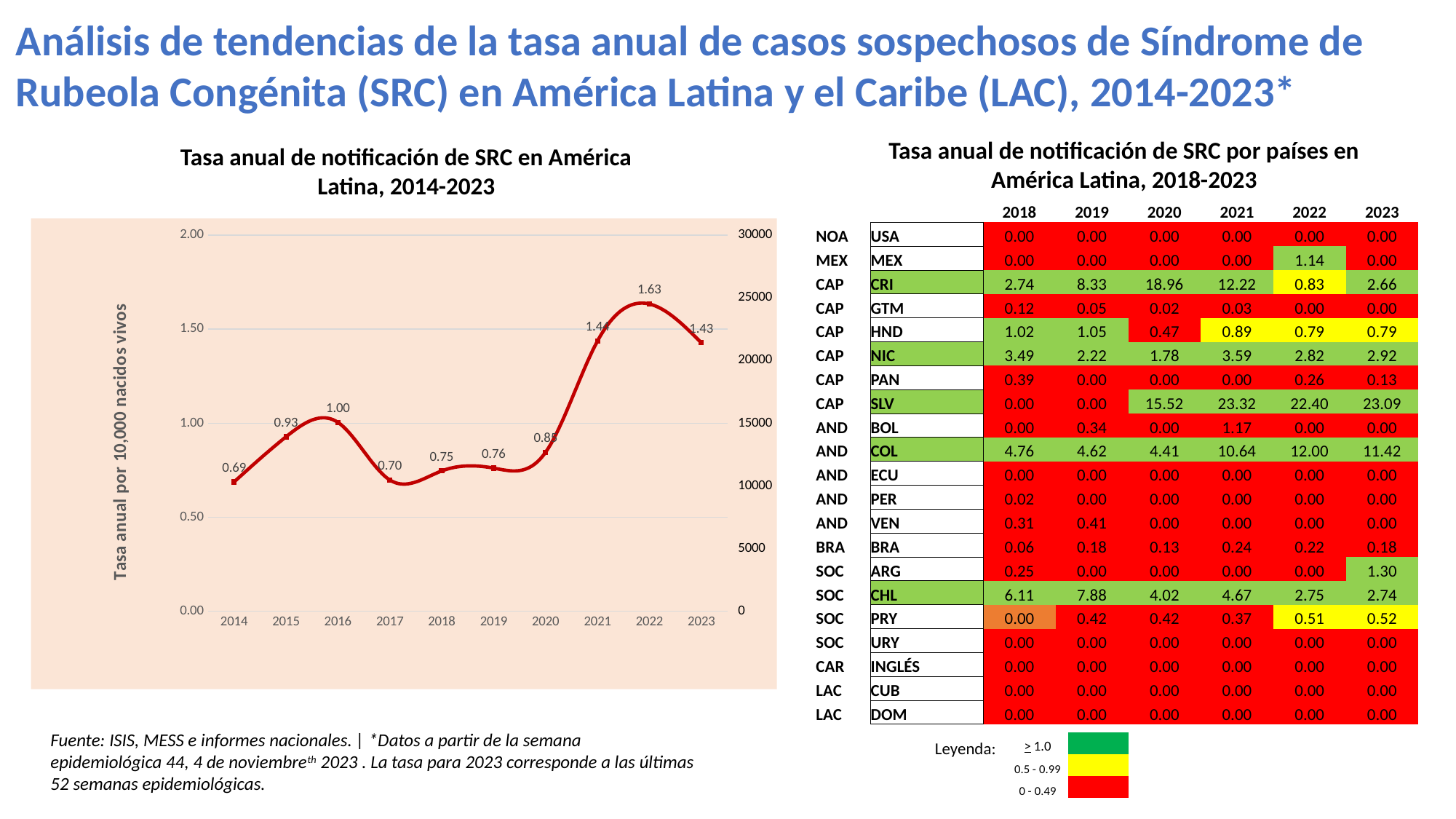
What type of chart is 'Tasa anual de notificación de SRC en América Latina, 2014-2023'? line chart In the line chart, which year has the highest annual SRC notification rate? 2022 In the line chart, what is the annual SRC notification rate for 2014? 0.69 In the line chart, which year has the lowest annual SRC notification rate? 2014 How many years are plotted on the x axis of the line chart? 10 What is the label of the left vertical axis of the line chart? Tasa anual por 10,000 nacidos vivos In the line chart, what is the difference between the 2021 value and the 2017 value? 0.74 In the line chart, does the value rise or fall from 2020 to 2022? rise In the line chart, what is the annual SRC notification rate for 2022? 1.63 In the line chart, what is the value for 2020? 0.85 In the line chart, what is the difference between the 2022 value and the 2023 value? 0.20 In the line chart, which year has a higher value, 2016 or 2019? 2016